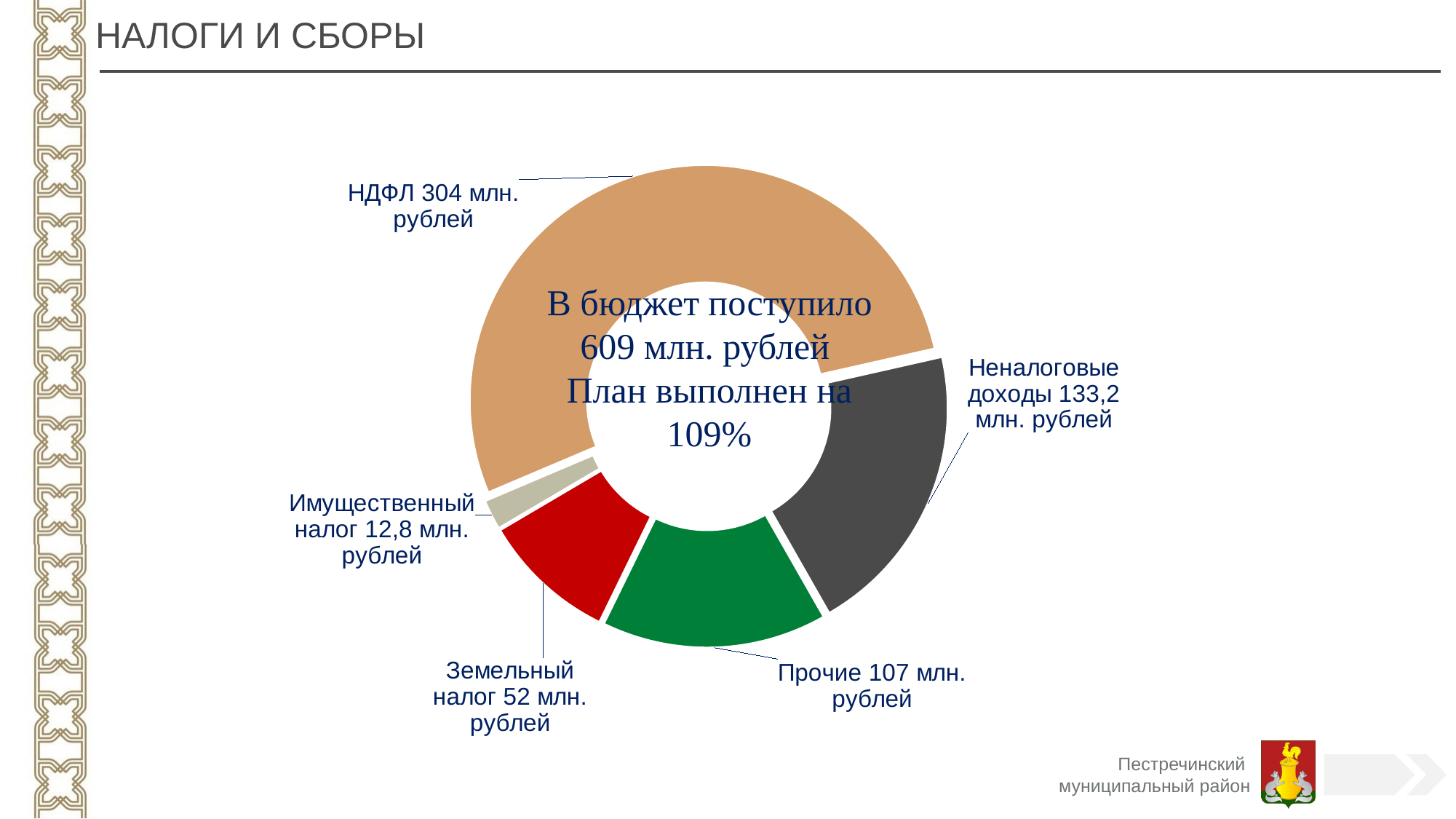
Which category has the largest value on the chart? НДФЛ What kind of chart is shown on the slide? Pie chart (donut) What is the difference between Прочие and Земельный налог? 55 млн. рублей Which is larger, Прочие or Земельный налог? Прочие What is the value for Неналоговые доходы on the chart? 133,2 млн. рублей What is the value for НДФЛ on the chart? 304 млн. рублей What total amount received by the budget is stated in the centre of the chart? 609 млн. рублей Which category has the smallest value on the chart? Имущественный налог What is the value for Земельный налог on the chart? 52 млн. рублей What is the value for Имущественный налог on the chart? 12,8 млн. рублей What is the difference between НДФЛ and Неналоговые доходы? 170,8 млн. рублей How many categories are shown on the chart? 5